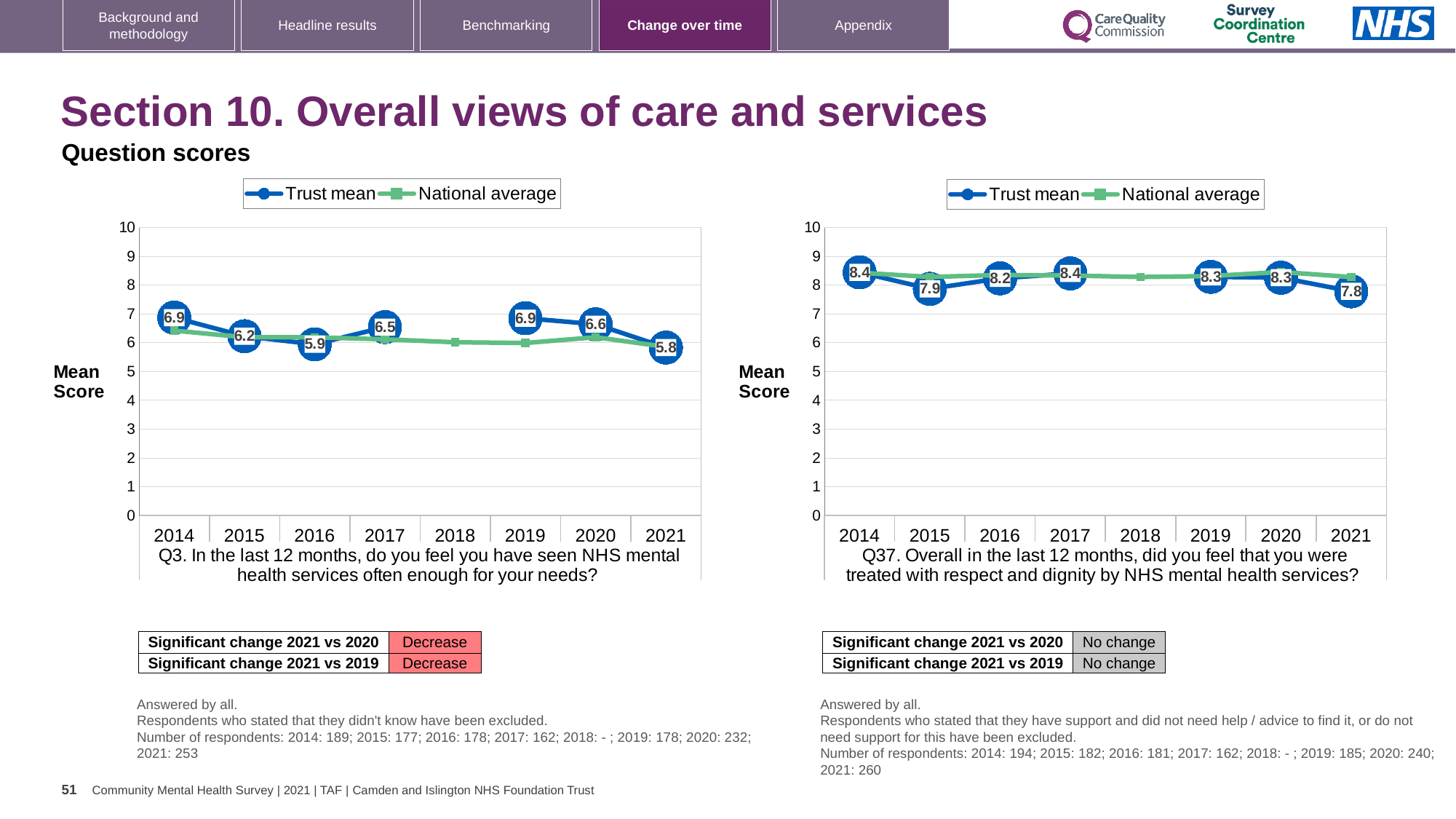
In the Q37 chart, what is the Trust mean for 2015? 7.9 What kind of chart is the Q37 chart? Line chart In the Q37 chart, which year has the lowest Trust mean? 2021 In the Q3 chart, what is the Trust mean for 2021? 5.8 How many series does the legend of the Q3 chart list? 2 How many years are shown on the x axis of the Q37 chart? 8 In the Q3 chart, is the National average for 2021 greater or less than 7? less In the Q3 chart, which year has the lowest Trust mean? 2021 In the Q37 chart, what is the Trust mean for 2019? 8.3 In the Q3 chart, what is the Trust mean for 2017? 6.5 In the Q3 chart, what is the difference between the Trust mean in 2020 and in 2021? 0.8 In the Q37 chart, is the Trust mean higher in 2014 or in 2015? 2014